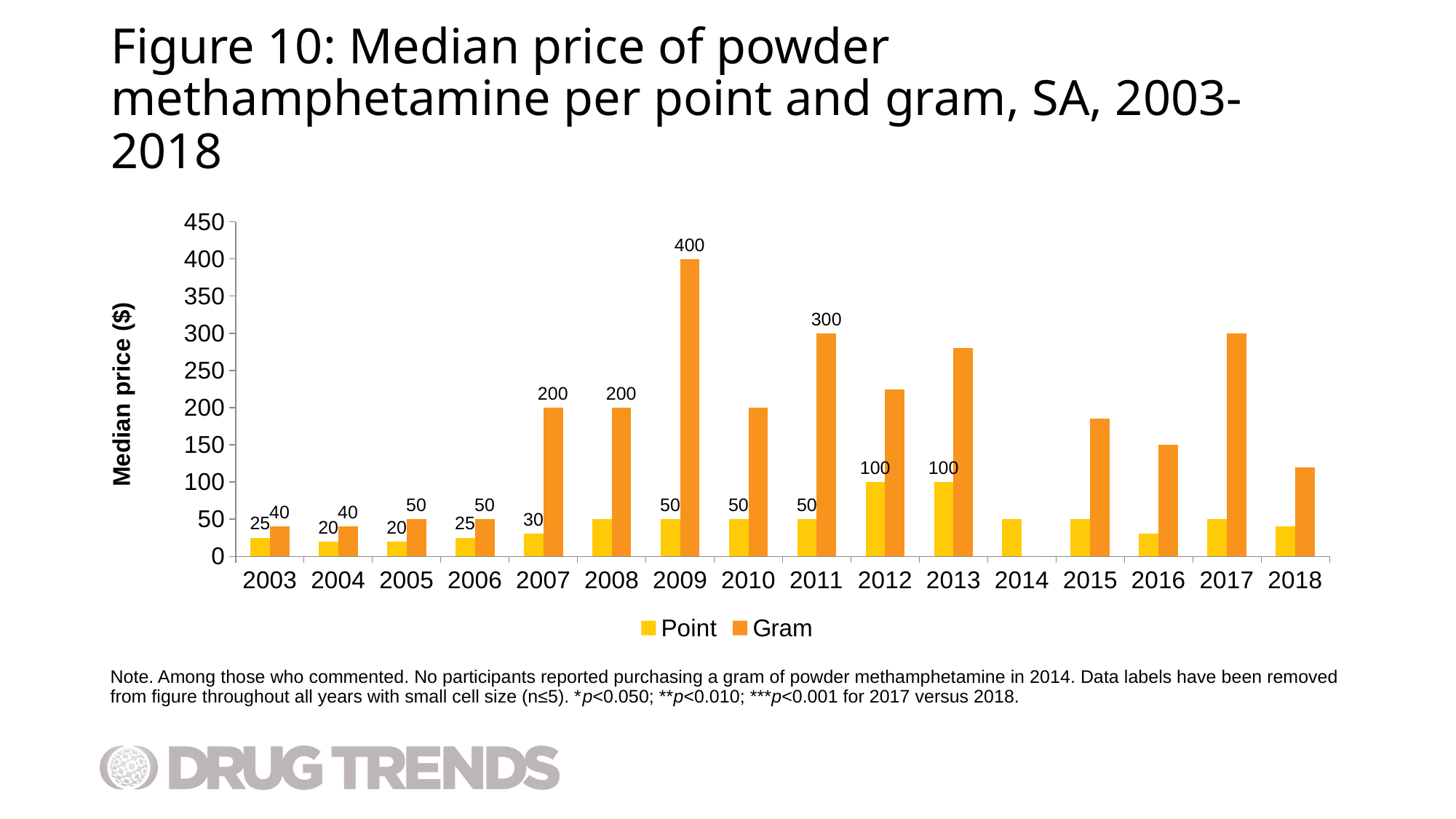
In which year is the median price per gram highest? 2009 What kind of chart is shown on the slide? bar chart What is the median price per point in 2007? 30 How many years are shown on the x axis? 16 What is the label on the vertical axis? Median price ($) Is the median price per gram in 2018 greater or less than 150? less How many series does the legend list? 2 What is the median price per point in 2012? 100 Is the median price per gram in 2013 greater or less than 250? greater What is the difference between the gram price and the point price in 2009? 350 Which is larger, the gram price in 2011 or the gram price in 2007? 2011 What is the median price per gram in 2009? 400